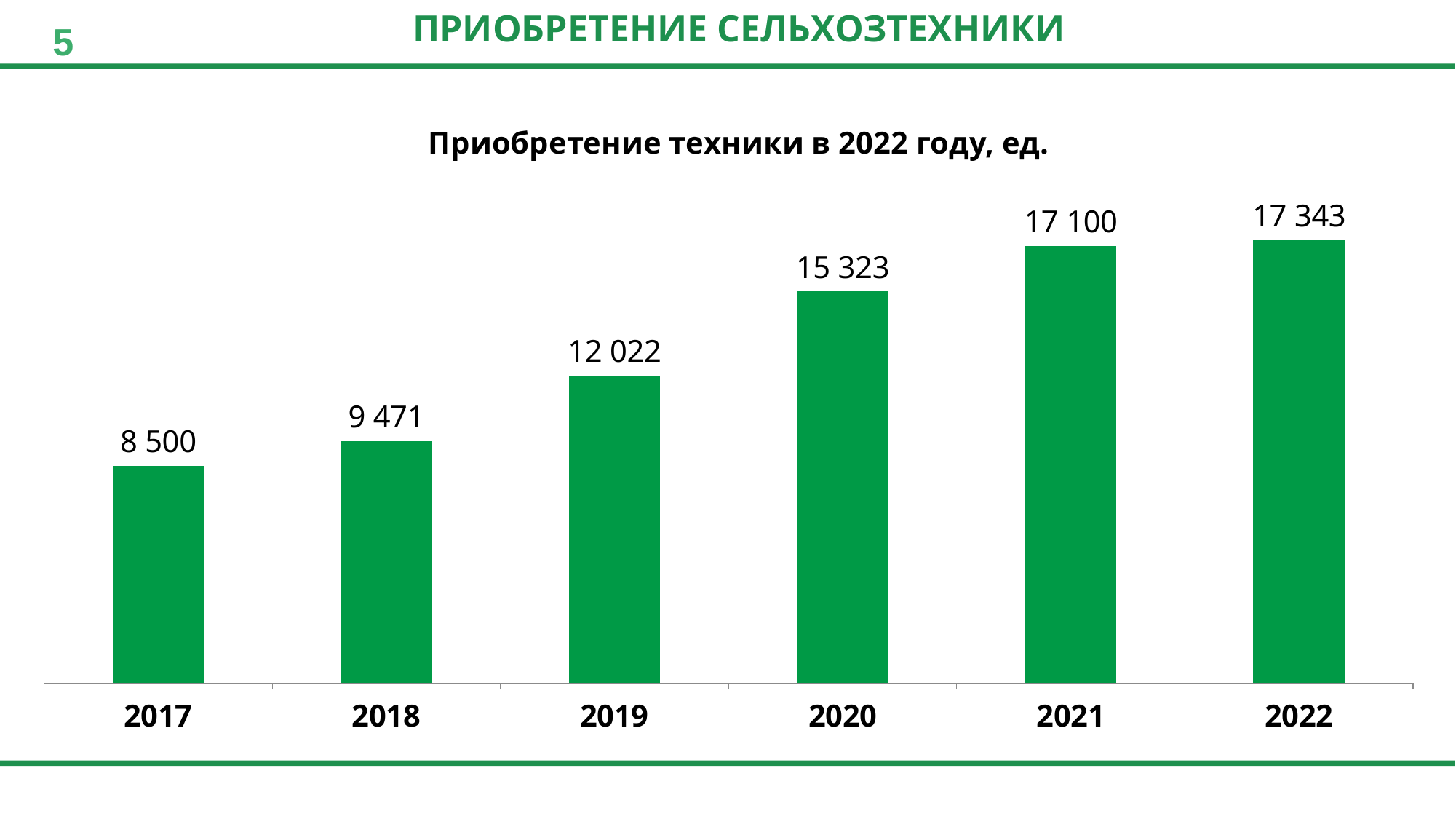
Which year has the lowest value? 2017 What is the value for 2017? 8 500 How many years are shown on the chart? 6 Which year has the highest value? 2022 Do the values rise or fall from 2017 to 2022? rise What kind of chart is this? bar chart What is the difference between the values for 2019 and 2018? 2 551 What is the difference between the values for 2022 and 2021? 243 Which is larger, the value for 2019 or the value for 2020? 2020 What is the value for 2020? 15 323 What is the value for 2022? 17 343 What is the title of the chart? Приобретение техники в 2022 году, ед.